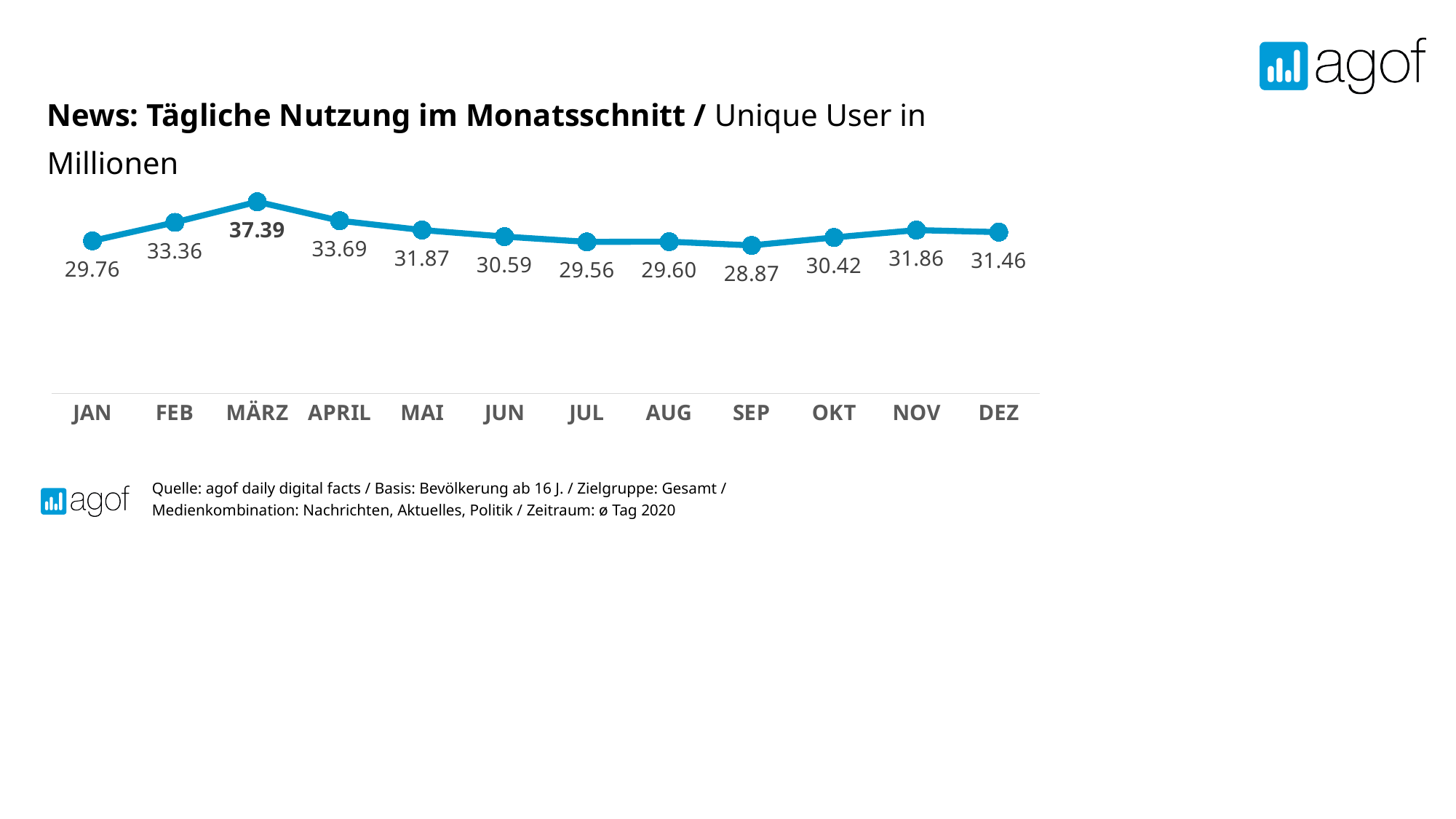
What is the difference between the values for JAN and FEB? 3.60 Which month has the highest value? MÄRZ What is the difference between the values for MÄRZ and SEP? 8.52 What is the value for SEP? 28.87 Which is larger, the value for NOV or the value for OKT? NOV What is the value for DEZ? 31.46 Which month has the lowest value? SEP Which is larger, the value for APRIL or the value for MAI? APRIL Do the values rise or fall from MÄRZ to SEP? Fall How many months are plotted on the chart? 12 What kind of chart is shown? Line chart What is the value for MÄRZ? 37.39